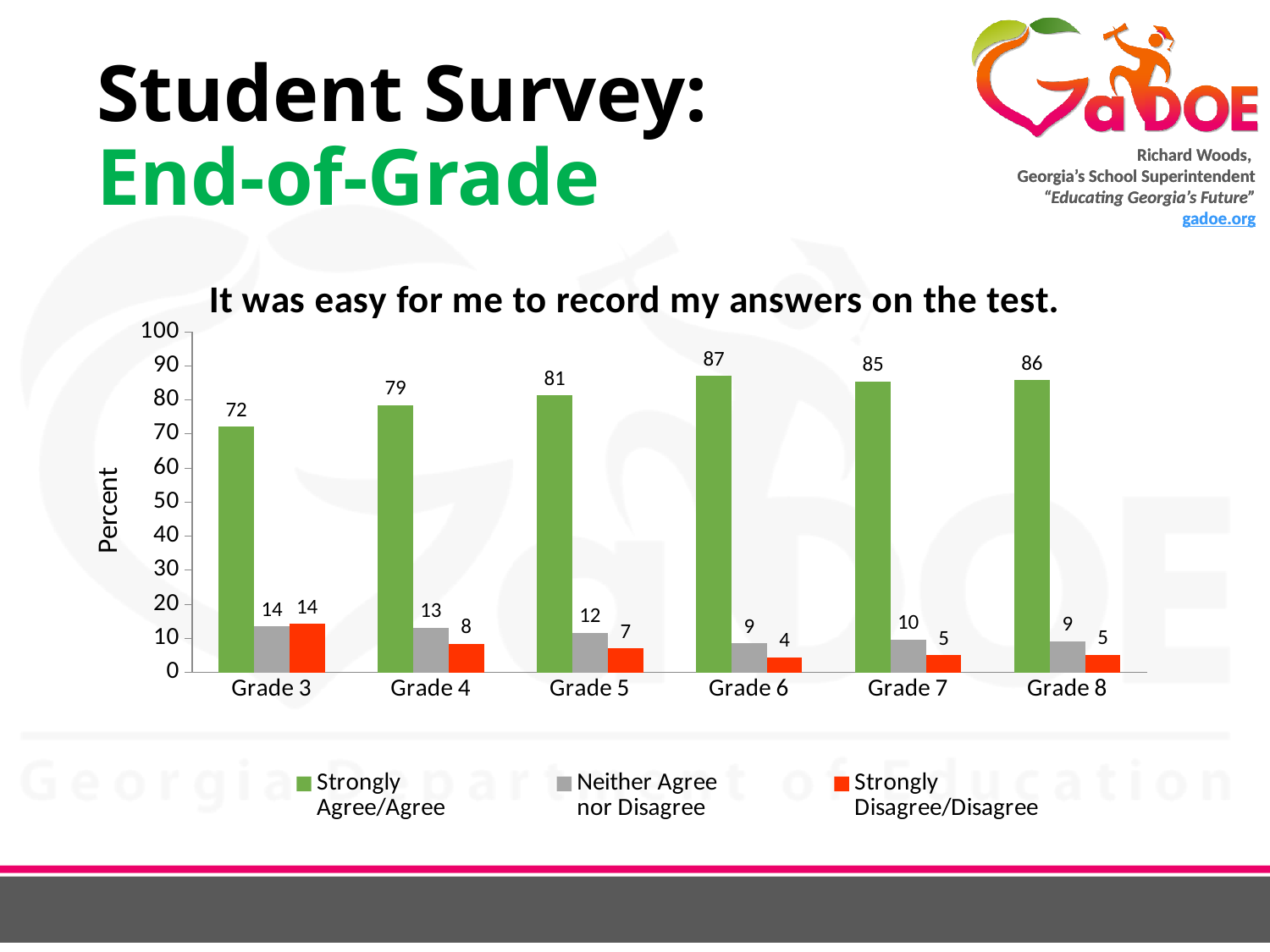
Which is larger: the Strongly Disagree/Disagree value for Grade 3 or for Grade 4? Grade 3 What percent of Grade 3 students Strongly Agree/Agree that it was easy to record their answers on the test? 72 What is the title of the chart? It was easy for me to record my answers on the test. What is the difference between the Strongly Agree/Agree values for Grade 6 and Grade 3? 15 How many grades are shown on the x axis? 6 How many series does the legend list? 3 What is the Strongly Disagree/Disagree value for Grade 6? 4 What is the Neither Agree nor Disagree value for Grade 7? 10 Which grade has the highest Strongly Agree/Agree value? Grade 6 What kind of chart is shown on the slide? Bar chart Which grade has the lowest Strongly Agree/Agree value? Grade 3 Do the Strongly Disagree/Disagree values generally rise or fall from Grade 3 to Grade 8? Fall